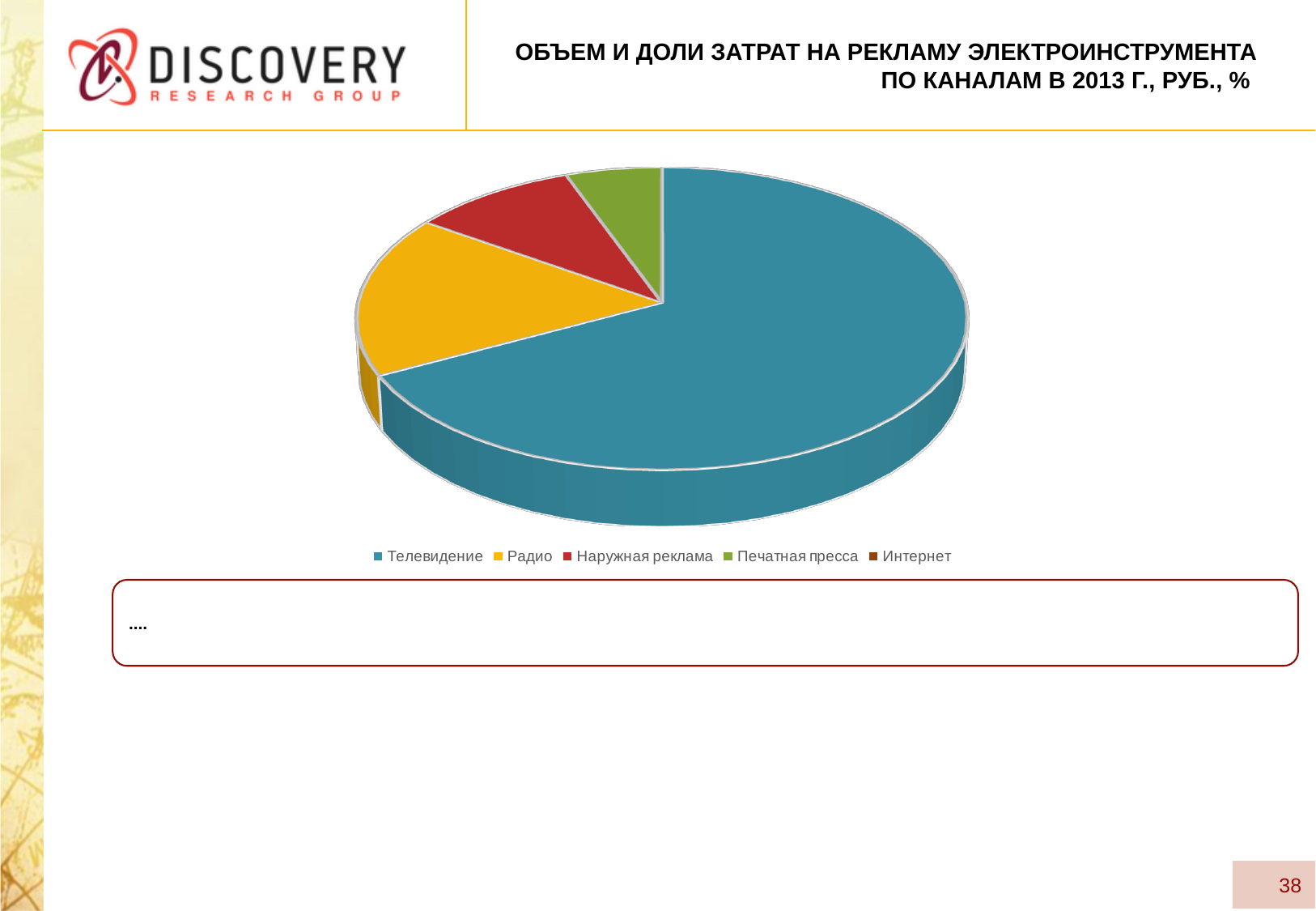
What colour is the Радио slice? Yellow How many entries does the legend list? 5 Which slice is larger, Наружная реклама or Печатная пресса? Наружная реклама Which slice is larger, Радио or Наружная реклама? Радио Which slice is larger, Телевидение or Радио? Телевидение Which advertising channel has the largest share of the pie? Телевидение What kind of chart is shown on the slide? Pie chart Which channel is the second-largest slice of the pie? Радио What year does the chart title refer to? 2013